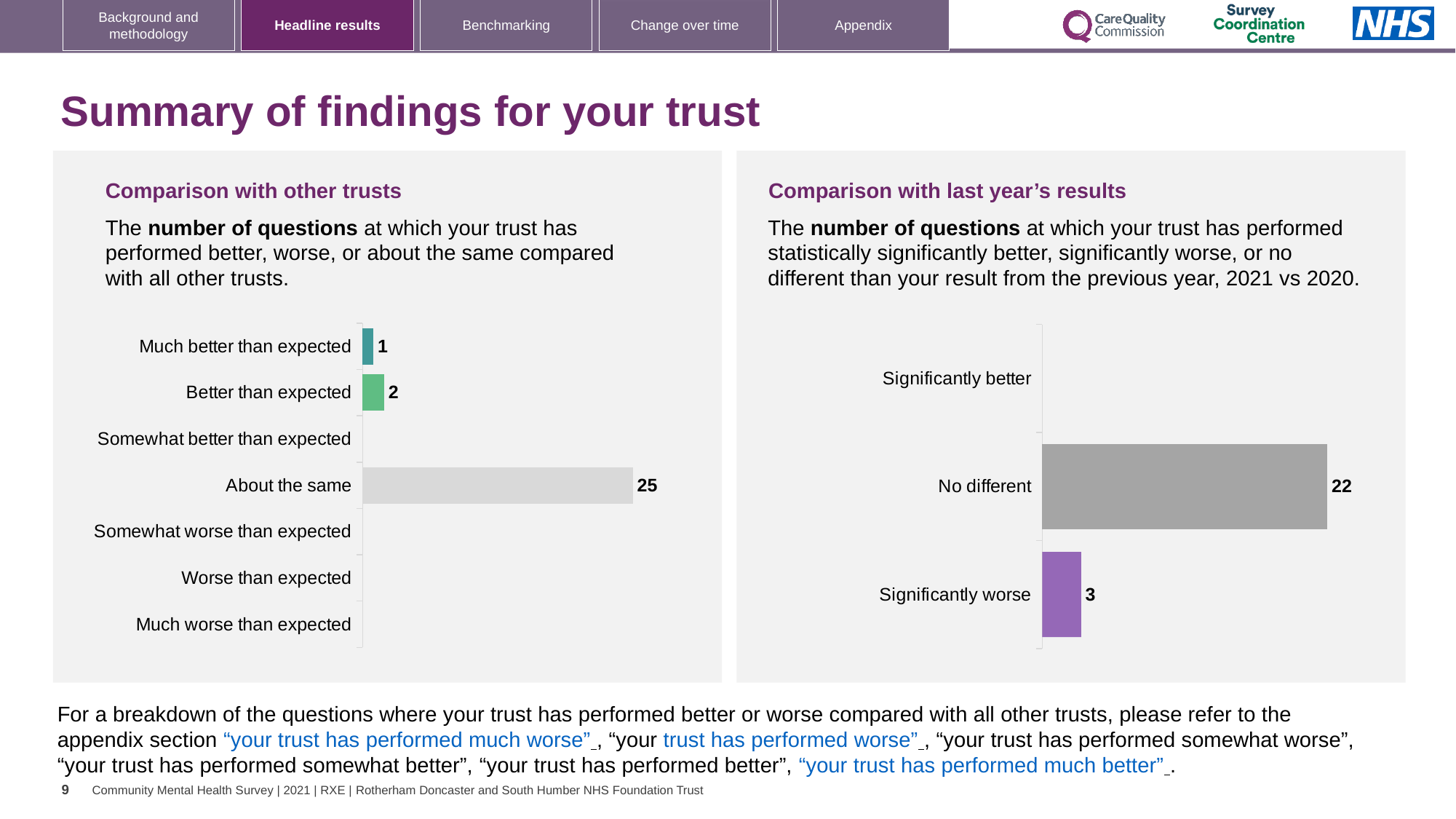
In the 'Comparison with last year's results' chart, what is the difference between 'No different' and 'Significantly worse'? 19 What type of chart is the 'Comparison with last year's results' chart? Bar chart How many categories are listed on the axis of the 'Comparison with last year's results' chart? 3 In the 'Comparison with last year's results' chart, what is the value for 'No different'? 22 In the 'Comparison with other trusts' chart, which is larger: 'Better than expected' or 'Much better than expected'? Better than expected In the 'Comparison with other trusts' chart, what is the value for 'About the same'? 25 In the 'Comparison with other trusts' chart, what is the value for 'Much better than expected'? 1 In the 'Comparison with other trusts' chart, which category has the highest value? About the same In the 'Comparison with other trusts' chart, what is the difference between 'About the same' and 'Better than expected'? 23 In the 'Comparison with other trusts' chart, what is the value for 'Better than expected'? 2 How many categories are listed on the axis of the 'Comparison with other trusts' chart? 7 In the 'Comparison with last year's results' chart, what is the value for 'Significantly worse'? 3